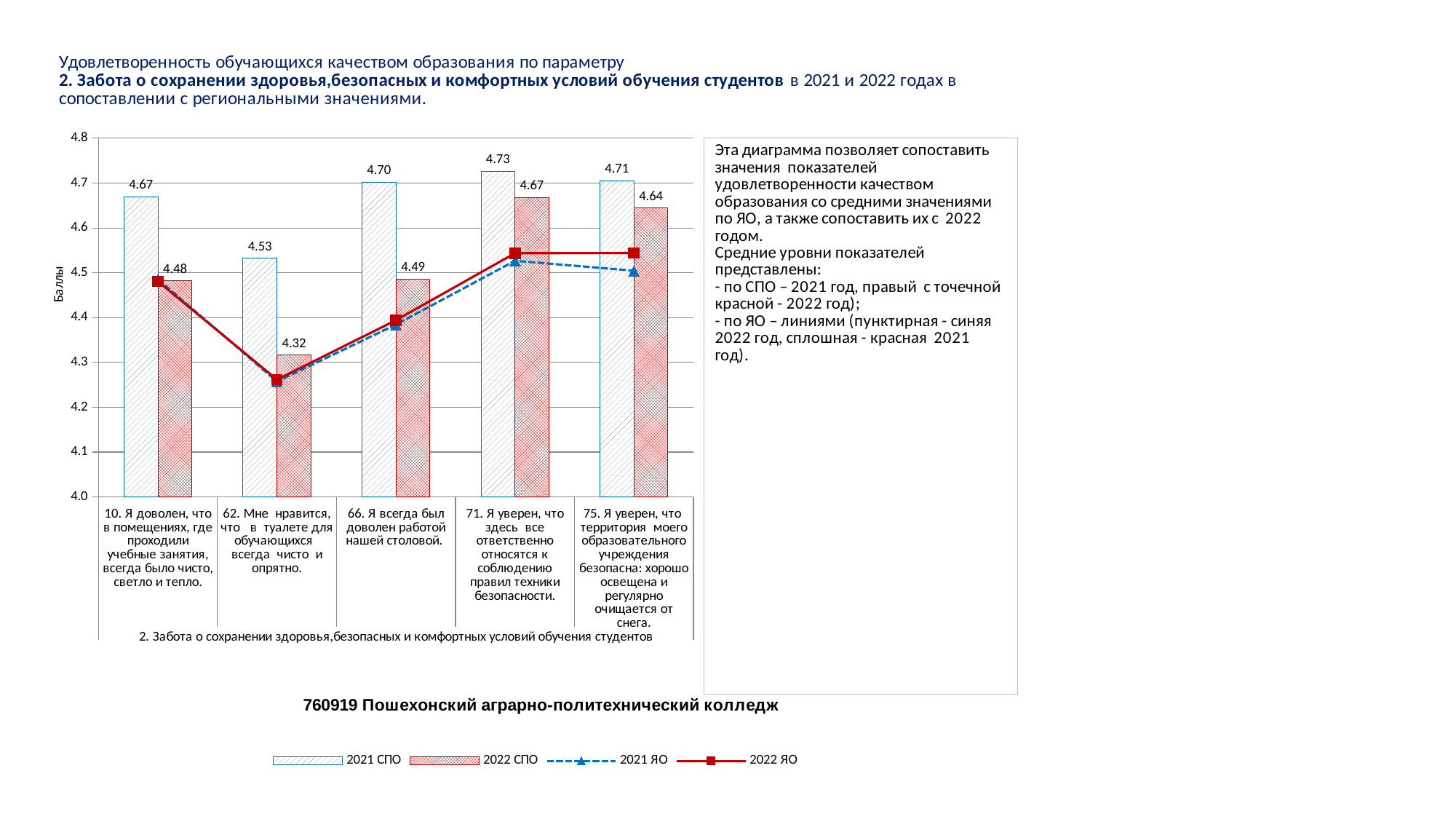
Which item has the lowest 2022 СПО value? 62. Мне нравится, что в туалете для обучающихся всегда чисто и опрятно. How many series does the legend list? 4 Which is larger for item 75: the 2021 СПО value or the 2022 СПО value? 2021 СПО What is the 2021 СПО value for item 10 ("Я доволен, что в помещениях, где проходили учебные занятия, всегда было чисто, светло и тепло")? 4.67 What kind of chart is shown on the slide? Combined bar and line chart What is the difference between the 2021 СПО and 2022 СПО values for item 66 ("Я всегда был доволен работой нашей столовой")? 0.21 What is the 2022 СПО value for item 62 ("Мне нравится, что в туалете для обучающихся всегда чисто и опрятно")? 4.32 Is the 2022 ЯО value for item 62 greater or less than 4.3? less What is the 2022 СПО value for item 71 ("Я уверен, что здесь все ответственно относятся к соблюдению правил техники безопасности")? 4.67 What is the label of the vertical axis? Баллы Which item has the highest 2021 СПО value? 71. Я уверен, что здесь все ответственно относятся к соблюдению правил техники безопасности. How many survey items (categories) are shown on the x axis? 5